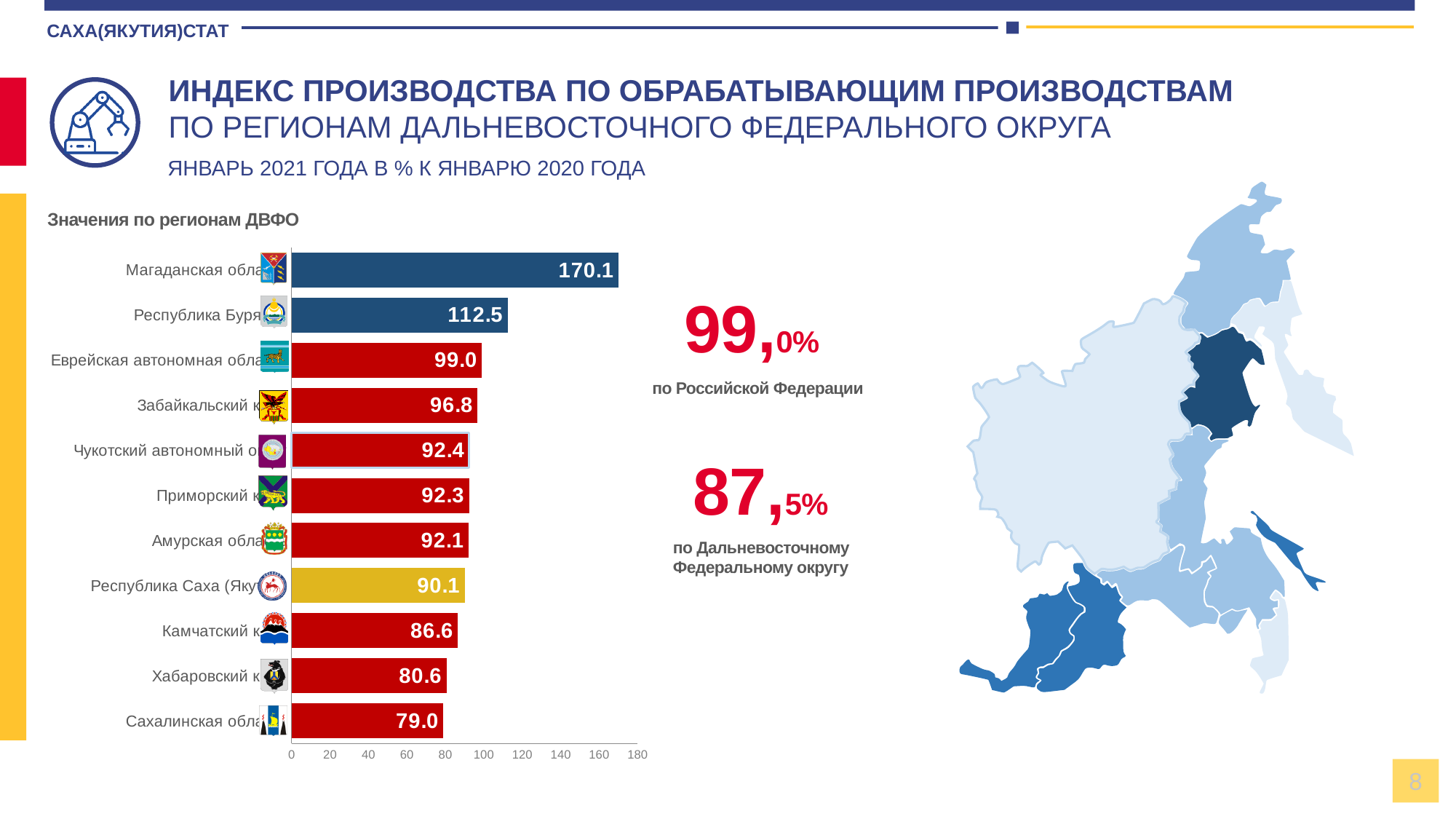
Is the value for Республика Бурятия greater or less than 100? greater What kind of chart is shown on the slide? bar chart What is the difference between the values for Магаданская область and Республика Бурятия? 57.6 Which region has the lowest value? Сахалинская область What is the difference between the values for Еврейская автономная область and Забайкальский край? 2.2 How many regions are shown in the bar chart? 11 What is the value for Магаданская область? 170.1 What is the value for Республика Саха (Якутия)? 90.1 Which region's bar is coloured yellow? Республика Саха (Якутия) What is the value for Хабаровский край? 80.6 Which region has the highest value? Магаданская область Which is larger, the value for Камчатский край or the value for Сахалинская область? Камчатский край